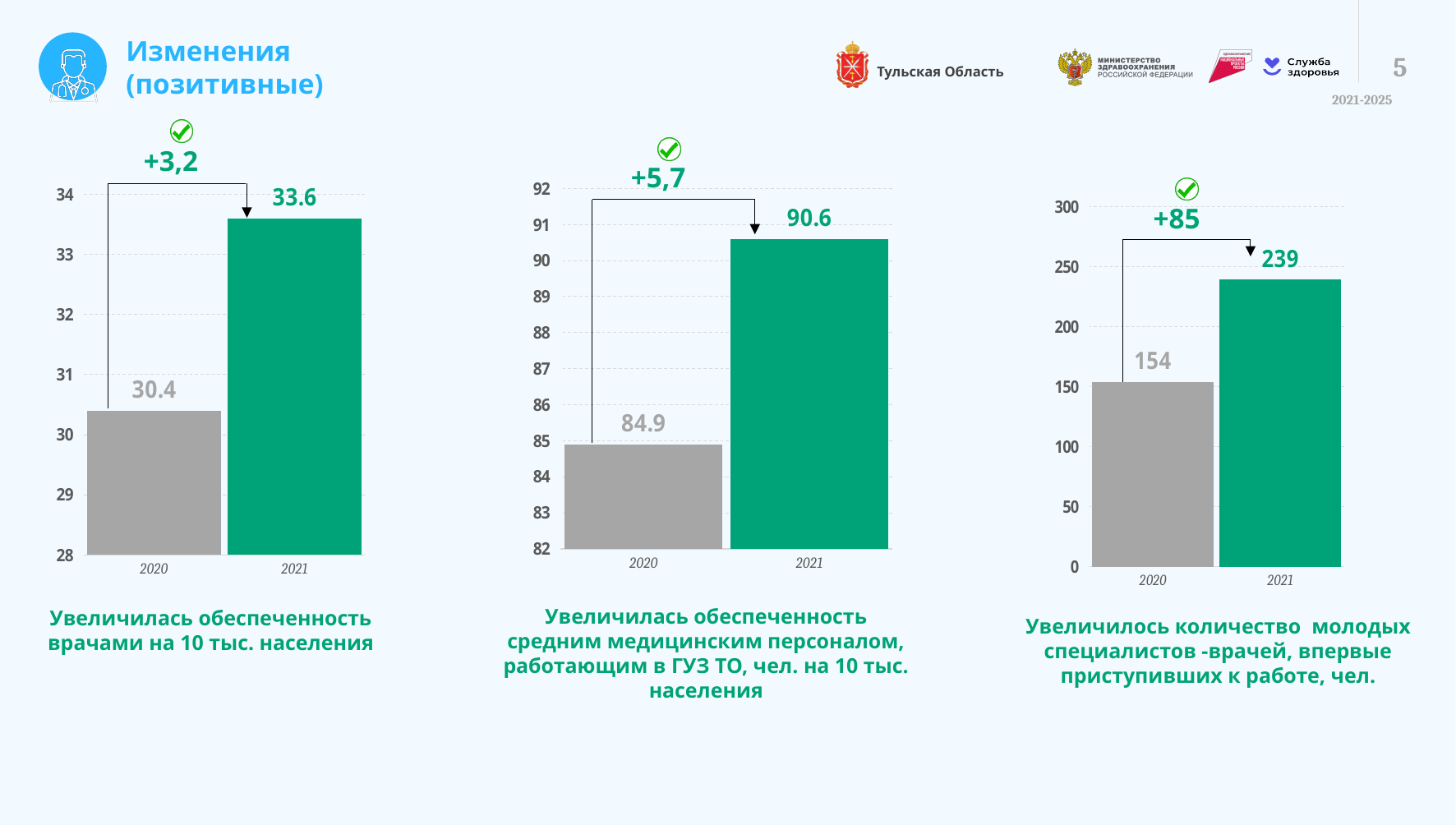
In the right chart, what is the difference between the 2021 and 2020 values? 85 In the left chart, what is the value for 2021? 33.6 What type of chart is the middle chart? bar chart In the middle chart, what is the value for 2021? 90.6 How many bar charts are shown on the slide? 3 In the right chart, is the value for 2020 greater or less than 200? less In the middle chart, what is the value for 2020? 84.9 In the left chart, what is the value for 2020? 30.4 In the left chart, which year has the higher value? 2021 In the right chart, what is the value for 2021? 239 In the right chart, which year has the lowest value? 2020 In the middle chart, what is the difference between the 2021 and 2020 values? 5.7